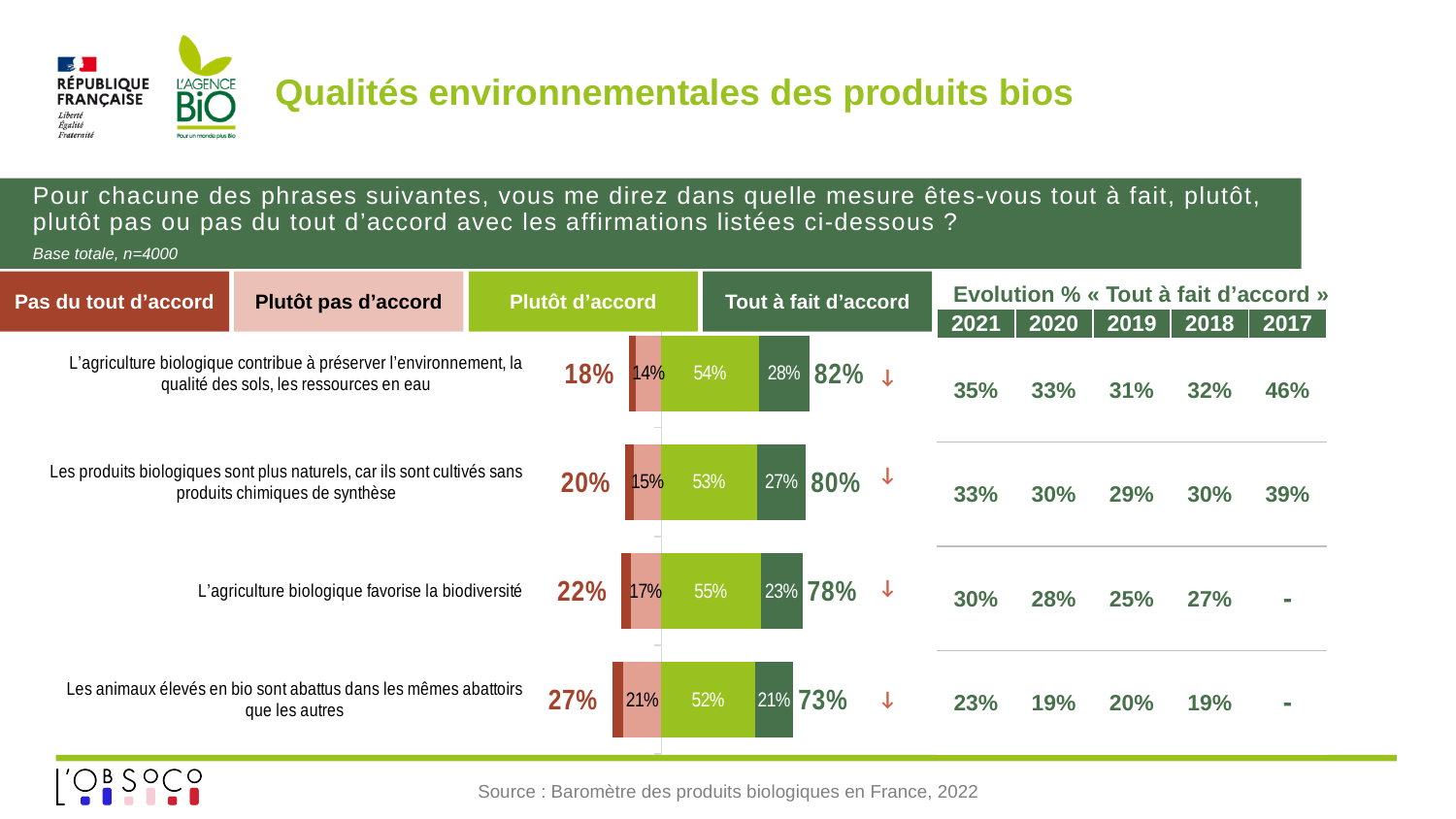
In the "Evolution % « Tout à fait d'accord »" table, what was the 2017 value for "Les produits biologiques sont plus naturels, car ils sont cultivés sans produits chimiques de synthèse"? 39% Which statement has the lowest "Tout à fait d'accord" share? Les animaux élevés en bio sont abattus dans les mêmes abattoirs que les autres What kind of chart is used to show the agreement levels for each statement? Stacked bar chart What is the "Tout à fait d'accord" value for the statement "L'agriculture biologique contribue à préserver l'environnement, la qualité des sols, les ressources en eau"? 28% How many response categories (series) does the legend list for the bar chart? 4 What is the "Plutôt pas d'accord" value for the statement "Les animaux élevés en bio sont abattus dans les mêmes abattoirs que les autres"? 21% Which statement has the larger "Plutôt d'accord" share: "L'agriculture biologique favorise la biodiversité" or "Les produits biologiques sont plus naturels, car ils sont cultivés sans produits chimiques de synthèse"? L'agriculture biologique favorise la biodiversité What percentage of respondents answered "Plutôt d'accord" to the statement "L'agriculture biologique favorise la biodiversité"? 55% What is the total disagreement (red figure to the left of the bar) for the statement "Les animaux élevés en bio sont abattus dans les mêmes abattoirs que les autres"? 27% Which statement has the highest total agreement (green total shown to the right of the bar)? L'agriculture biologique contribue à préserver l'environnement, la qualité des sols, les ressources en eau How many statements are plotted in the bar chart? 4 What is the difference between the total agreement for "L'agriculture biologique contribue à préserver l'environnement..." (82%) and for "Les animaux élevés en bio sont abattus dans les mêmes abattoirs que les autres" (73%)? 9 percentage points